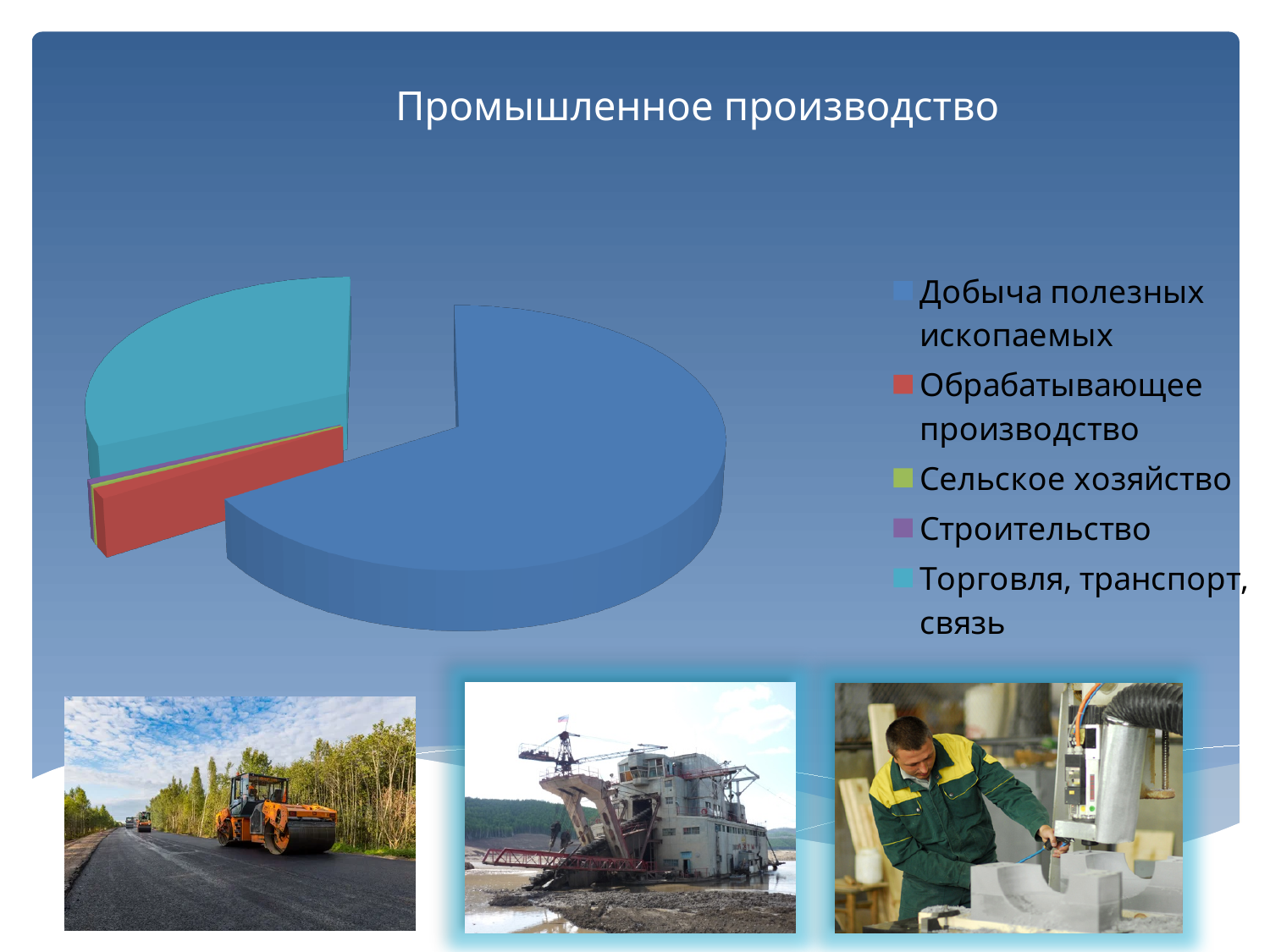
What is the title of the chart? Промышленное производство What colour is the slice for Обрабатывающее производство? Red How many categories does the pie chart have? 5 Which category has the largest slice of the pie? Добыча полезных ископаемых Which slice is larger: Торговля, транспорт, связь or Обрабатывающее производство? Торговля, транспорт, связь Which slice is larger: Обрабатывающее производство or Сельское хозяйство? Обрабатывающее производство Which category is shown in the legend with a light blue (teal) colour? Торговля, транспорт, связь What kind of chart is shown on the slide? Pie chart Which slice is larger: Добыча полезных ископаемых or Торговля, транспорт, связь? Добыча полезных ископаемых